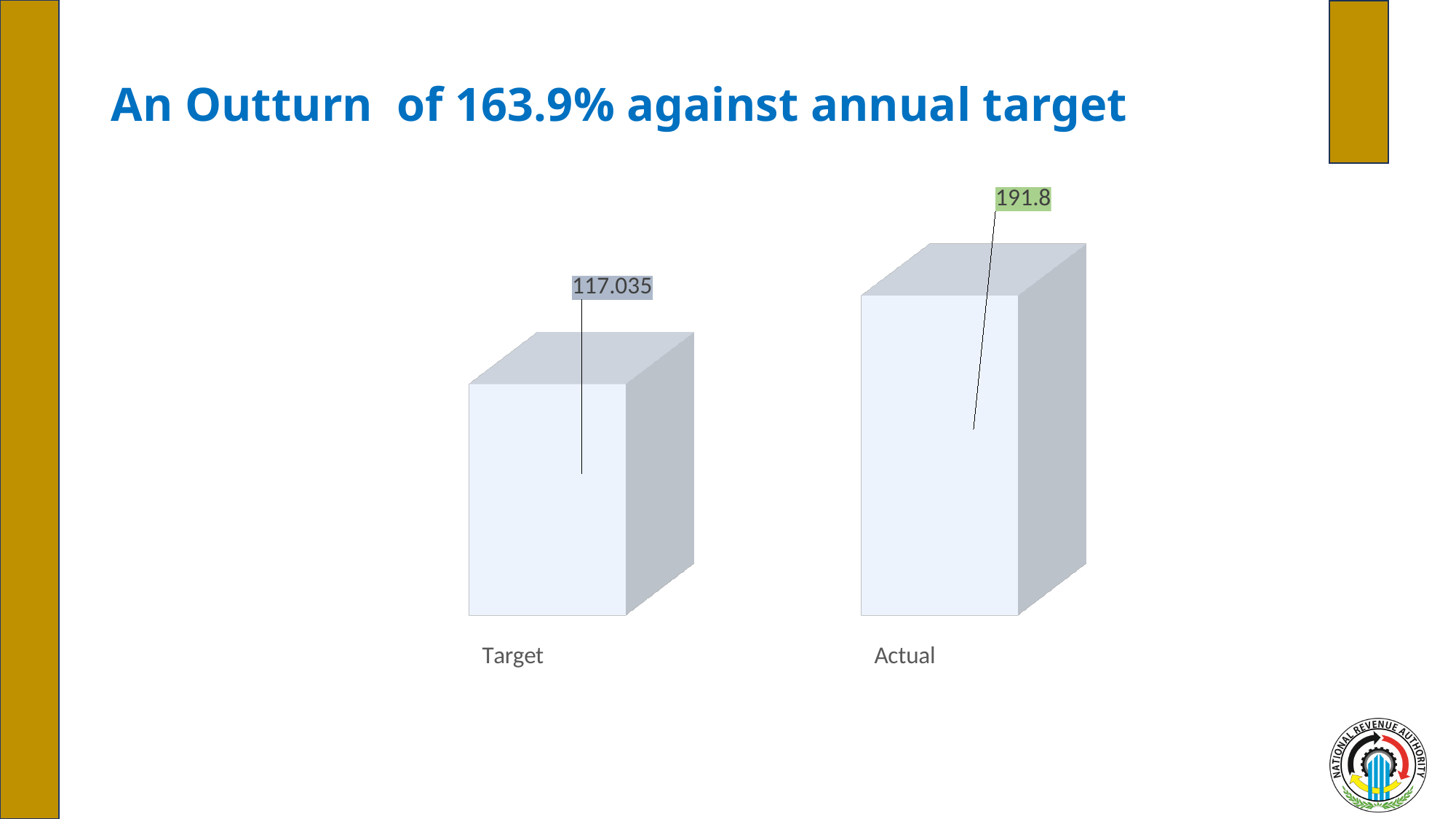
What are the category labels on the x axis? Target, Actual How many categories are shown in the chart? 2 Do the values rise or fall from Target to Actual? Rise Which category has the lowest value? Target What is the value for Target? 117.035 What kind of chart is shown on the slide? Bar chart Which category has the highest value? Actual What is the value for Actual? 191.8 What is the title of the slide? An Outturn of 163.9% against annual target What is the difference between the Actual and Target values? 74.765 Which is larger, the value for Target or the value for Actual? Actual